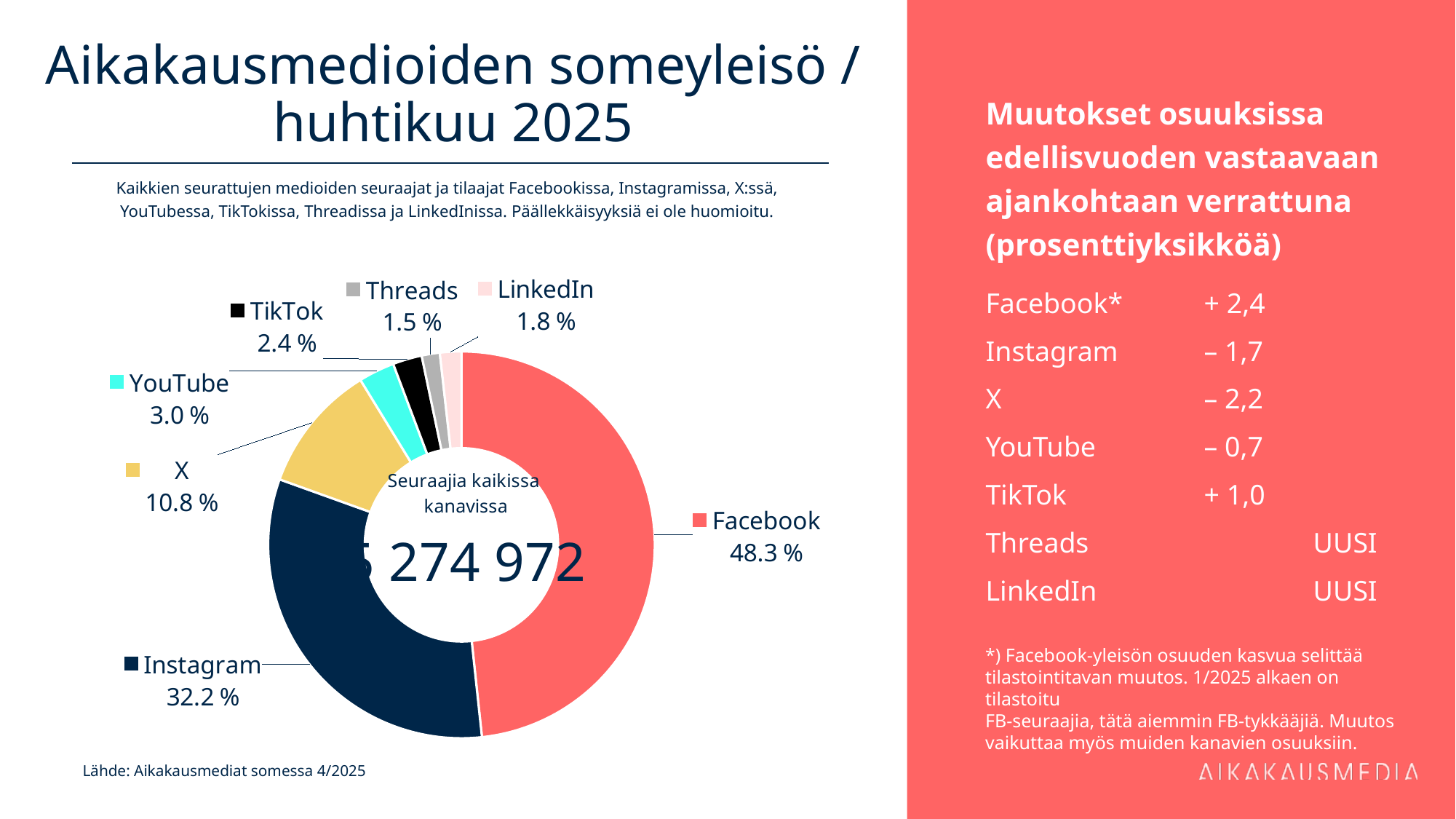
Which is larger, the share for LinkedIn or the share for Threads? LinkedIn What kind of chart is shown on the slide? pie chart (donut) What percentage is shown for X? 10.8 % How many channels (slices) are shown in the chart? 7 What share of the social media audience does Facebook have? 48.3 % What is the value shown for TikTok? 2.4 % Which channel has the smallest share in the chart? Threads What is the difference between the shares of X and YouTube? 7.8 What is the difference in percentage points between Facebook and Instagram? 16.1 What is the value shown for Instagram? 32.2 % Which channel has the largest share in the chart? Facebook What total number of followers across all channels is shown in the centre of the chart? 5 274 972